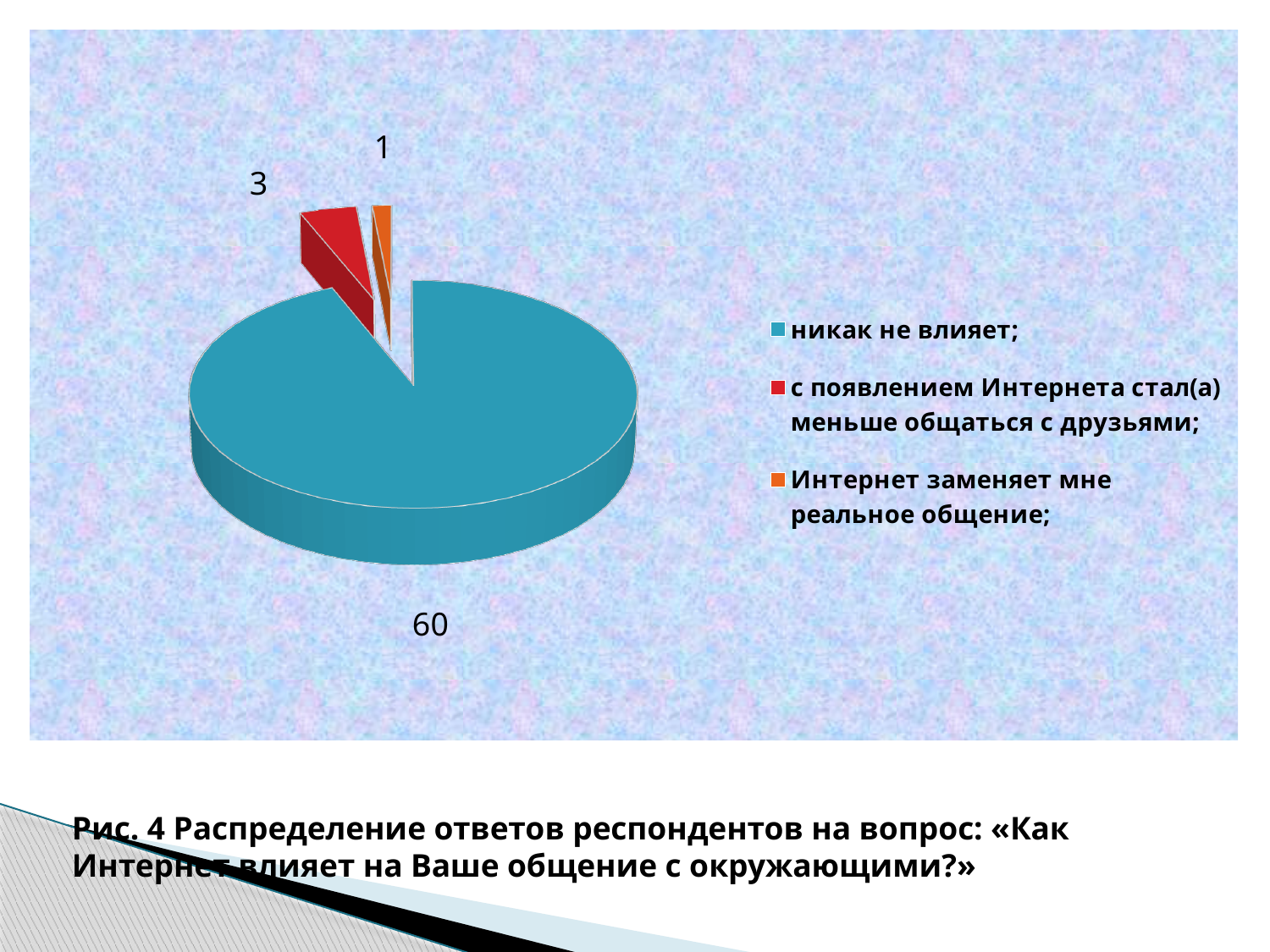
What value is shown for the slice "Интернет заменяет мне реальное общение;"? 1 Which response has the largest slice of the pie? никак не влияет; What type of chart is shown on the slide? Pie chart What value is shown for the slice "никак не влияет;"? 60 What is the difference between the value for "с появлением Интернета стал(а) меньше общаться с друзьями;" and the value for "Интернет заменяет мне реальное общение;"? 2 Which response has the smallest slice of the pie? Интернет заменяет мне реальное общение; How many slices does the pie chart have? 3 What value is shown for the slice "с появлением Интернета стал(а) меньше общаться с друзьями;"? 3 What colour is the slice for "никак не влияет;"? Blue (teal) Which is larger: the value for "с появлением Интернета стал(а) меньше общаться с друзьями;" or the value for "Интернет заменяет мне реальное общение;"? с появлением Интернета стал(а) меньше общаться с друзьями; What is the difference between the value for "никак не влияет;" and the value for "с появлением Интернета стал(а) меньше общаться с друзьями;"? 57 What is the total of all the values shown on the pie chart? 64